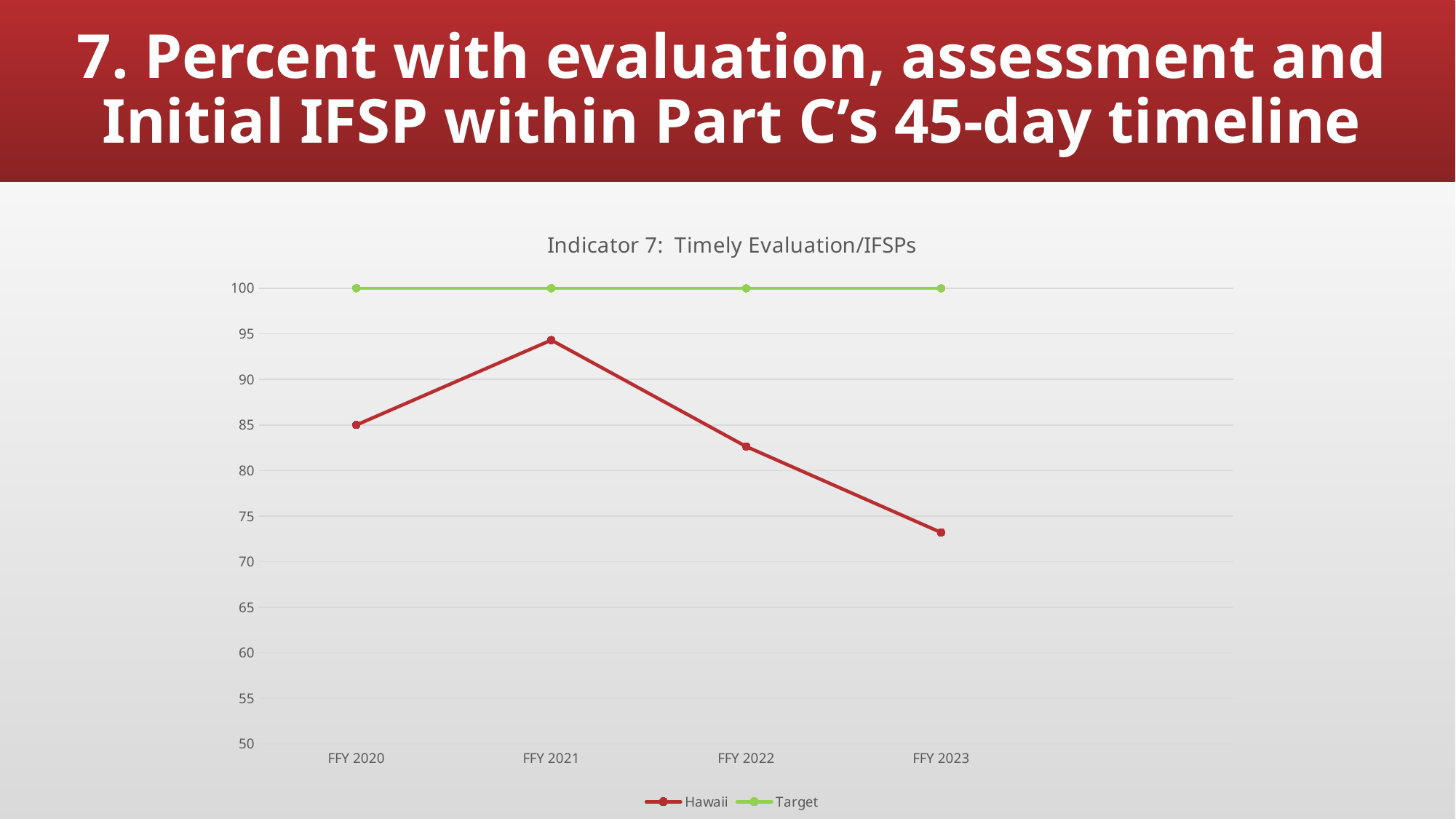
How many series does the legend list? 2 In which fiscal year is the Hawaii value highest? FFY 2021 Is the Hawaii value for FFY 2021 greater or less than 90? greater Does the Hawaii line rise or fall from FFY 2021 to FFY 2023? fall What colour is the Target line? green What is the Target value for FFY 2021? 100 What is the title of the chart? Indicator 7: Timely Evaluation/IFSPs Is the Hawaii value for FFY 2023 greater or less than 75? less How many fiscal years are plotted along the x axis? 4 What kind of chart is shown on the slide? line chart Which is larger for Hawaii: the value for FFY 2020 or the value for FFY 2022? FFY 2020 In which fiscal year is the Hawaii value lowest? FFY 2023